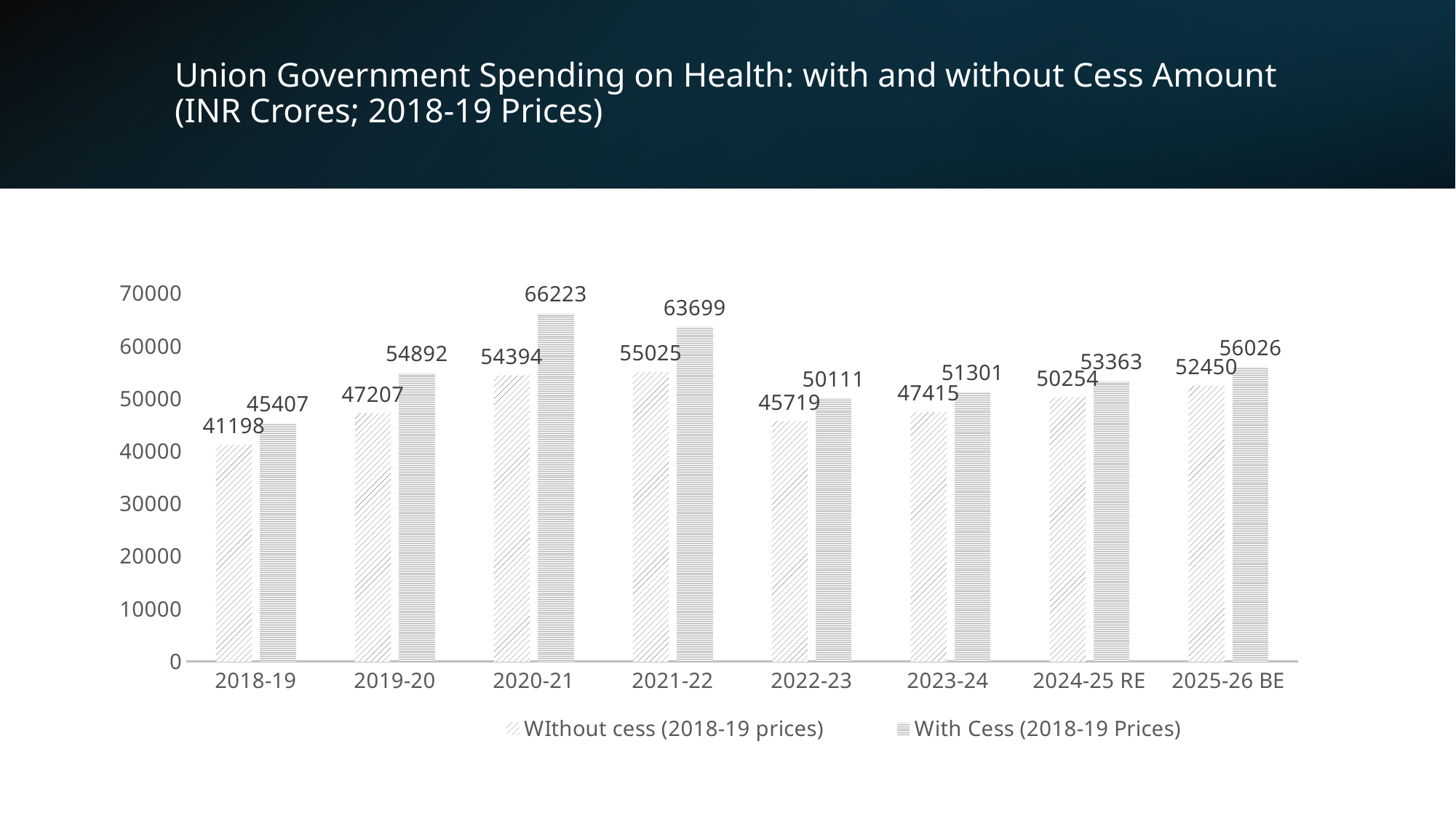
Which is larger: the 'WIthout cess' value in 2020-21 or the 'WIthout cess' value in 2021-22? 2021-22 Which year has the lowest value for 'WIthout cess (2018-19 prices)'? 2018-19 How many series does the legend list? 2 What is the value for 'With Cess (2018-19 Prices)' in 2020-21? 66223 What is the value for 'WIthout cess (2018-19 prices)' in 2018-19? 41198 How many years are shown on the x axis? 8 What kind of chart is shown on the slide? bar chart Does the 'WIthout cess (2018-19 prices)' value rise or fall from 2021-22 to 2022-23? fall Is the 'With Cess (2018-19 Prices)' value for 2022-23 greater or less than 60000? less Which year has the highest value for 'With Cess (2018-19 Prices)'? 2020-21 What is the difference between the 'With Cess' and 'WIthout cess' values in 2021-22? 8674 What is the value for 'With Cess (2018-19 Prices)' in 2025-26 BE? 56026